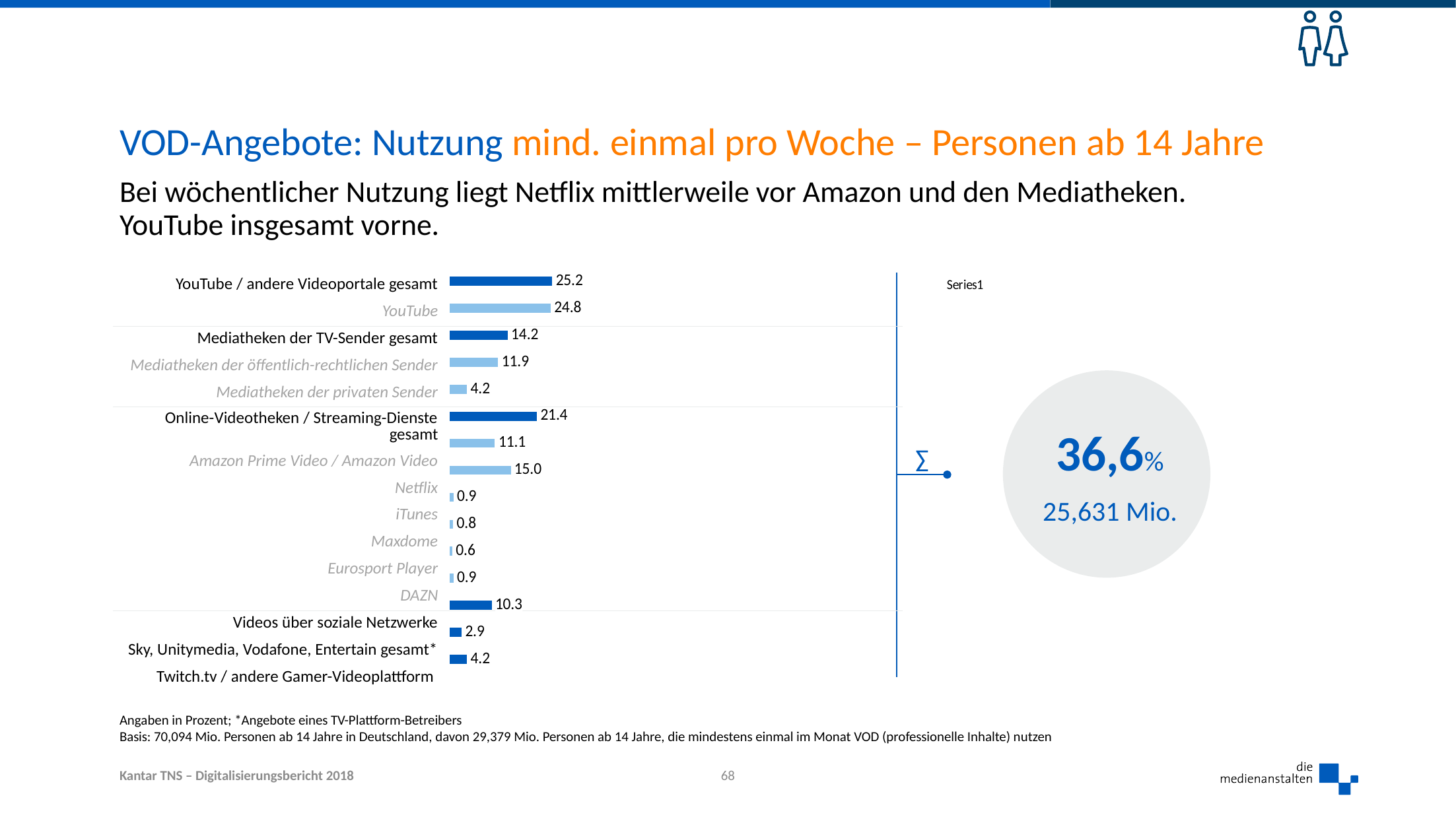
What is the value for YouTube / andere Videoportale gesamt? 25.2 What is the difference between the values for YouTube / andere Videoportale gesamt and Mediatheken der TV-Sender gesamt? 11.0 What is the value for Mediatheken der TV-Sender gesamt? 14.2 What is the difference between the values for Mediatheken der öffentlich-rechtlichen Sender and Mediatheken der privaten Sender? 7.7 What is the value for Mediatheken der öffentlich-rechtlichen Sender? 11.9 What is the value for Mediatheken der privaten Sender? 4.2 What is the value for Online-Videotheken / Streaming-Dienste gesamt? 21.4 How many series does the legend list? 1 Which is larger: Mediatheken der TV-Sender gesamt or Online-Videotheken / Streaming-Dienste gesamt? Online-Videotheken / Streaming-Dienste gesamt What is the value for YouTube? 24.8 Which category has the highest value in the chart? YouTube / andere Videoportale gesamt What kind of chart is shown on the slide? bar chart